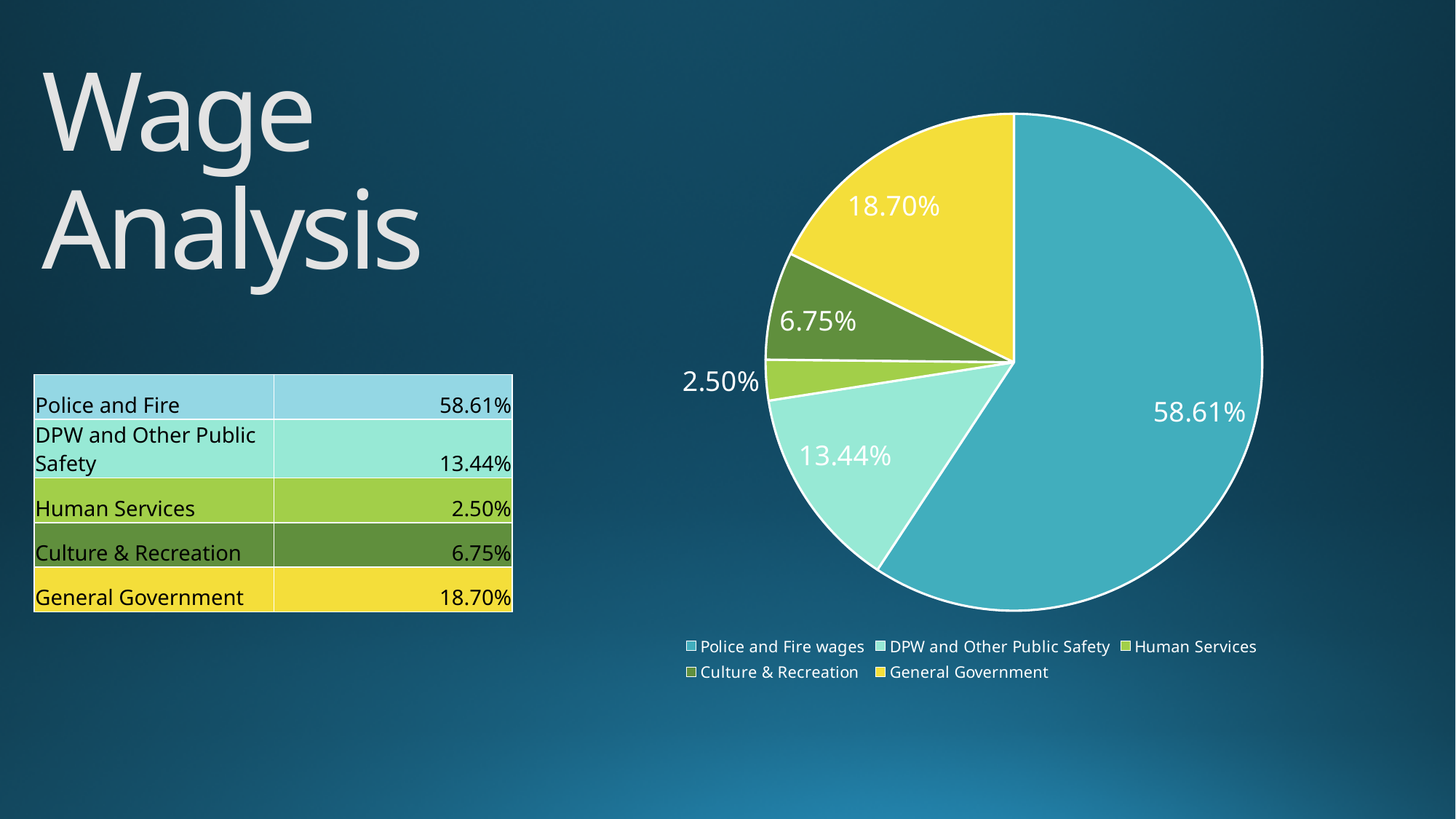
What colour is the General Government slice? Yellow What kind of chart is shown on the slide? Pie chart What share of the pie does Police and Fire wages take? 58.61% What is the value shown for DPW and Other Public Safety? 13.44% What is the difference between the General Government and Culture & Recreation values? 11.95% What is the value shown for Culture & Recreation? 6.75% What is the value shown for General Government? 18.70% Which category has the smallest slice of the pie? Human Services Which is larger, DPW and Other Public Safety or General Government? General Government What is the value shown for Human Services? 2.50% Which category has the largest slice of the pie? Police and Fire wages How many slices does the pie chart have? 5